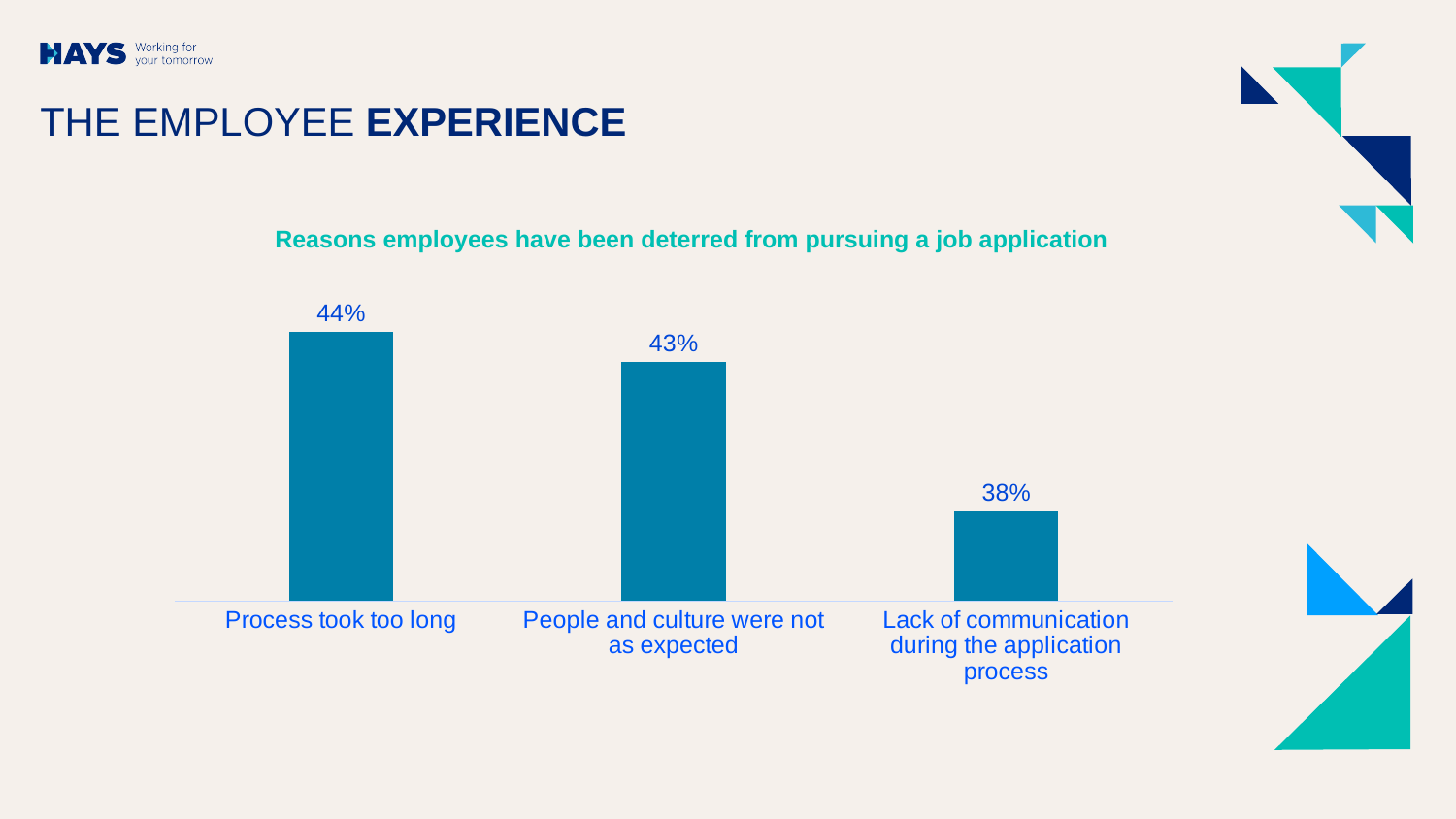
Which reason has the lowest percentage? Lack of communication during the application process How many reasons are shown in the chart? 3 What is the difference in percentage points between 'People and culture were not as expected' and 'Lack of communication during the application process'? 5 Do the values rise or fall from left to right across the chart? Fall What is the value for 'People and culture were not as expected'? 43% What kind of chart is shown on the slide? Bar chart What is the title of the chart? Reasons employees have been deterred from pursuing a job application What is the difference in percentage points between 'Process took too long' and 'Lack of communication during the application process'? 6 Which reason has the highest percentage? Process took too long What is the value for 'Lack of communication during the application process'? 38% Which is larger: the value for 'People and culture were not as expected' or for 'Lack of communication during the application process'? People and culture were not as expected What percentage of employees were deterred because the process took too long? 44%